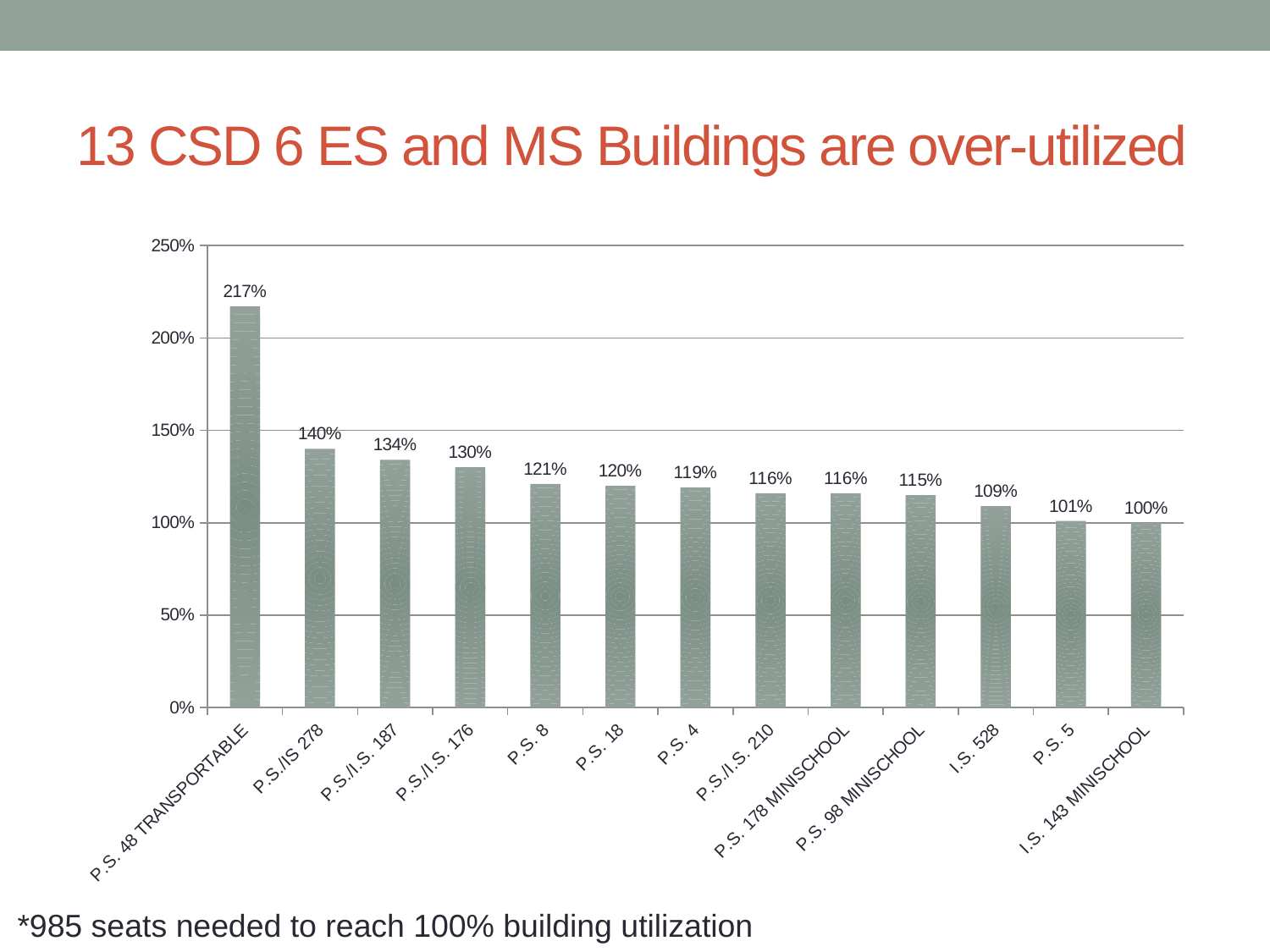
What is the difference between the utilization of P.S. 48 TRANSPORTABLE and P.S./IS 278? 77% Which building has the highest utilization? P.S. 48 TRANSPORTABLE Do the values rise or fall from left to right along the x axis? Fall What is the utilization value for P.S. 48 TRANSPORTABLE? 217% Which building has the lowest utilization? I.S. 143 MINISCHOOL What is the utilization value for P.S./I.S. 187? 134% What is the utilization value for I.S. 528? 109% Which has a higher utilization, P.S./I.S. 176 or P.S. 18? P.S./I.S. 176 Is the value for P.S./IS 278 greater or less than 150%? less What is the difference between the utilization of P.S. 8 and P.S. 5? 20% How many buildings are shown in the chart? 13 What kind of chart is shown on the slide? Bar chart